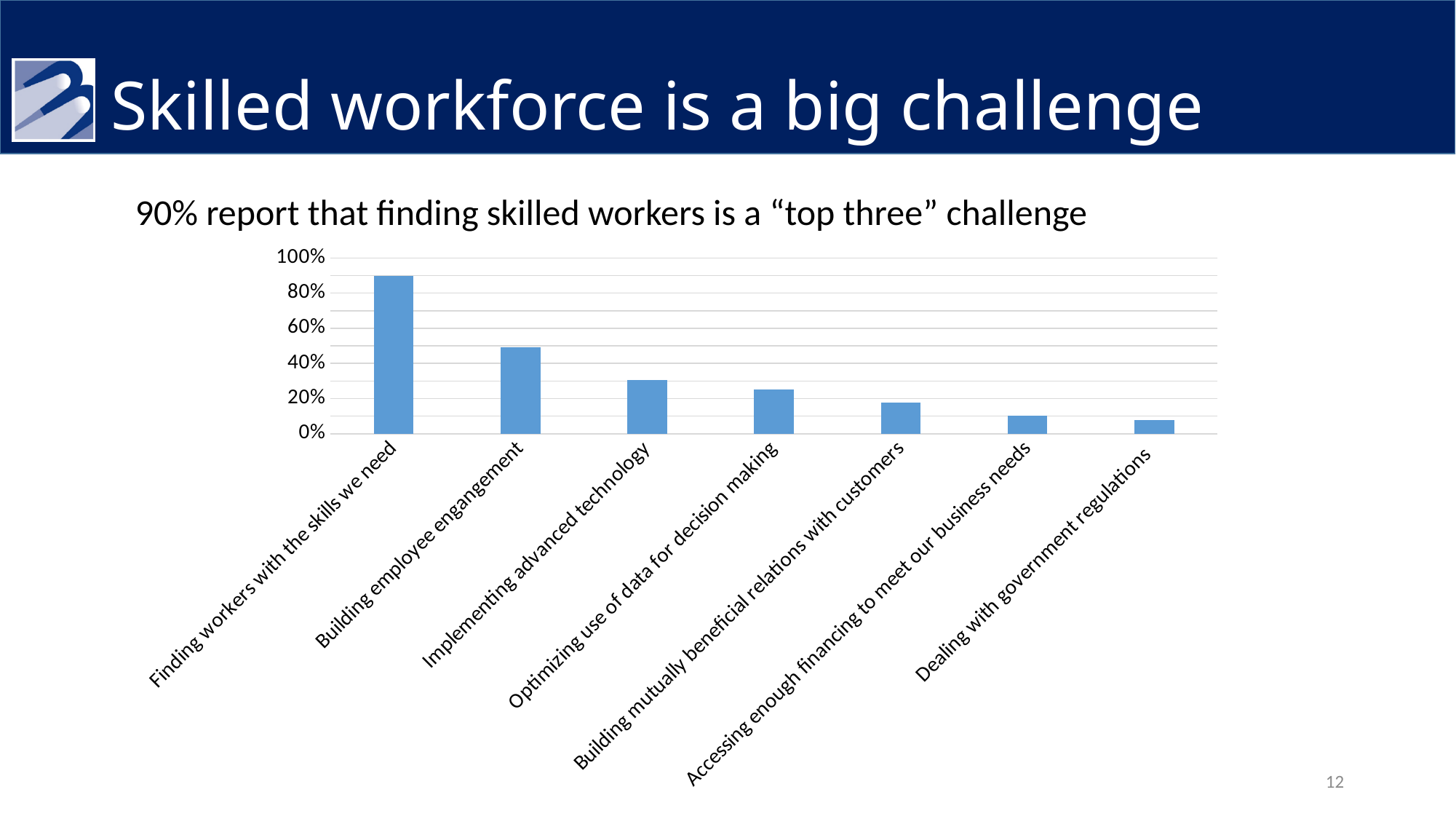
Is the value for Implementing advanced technology greater or less than 40%? less Do the bar values rise or fall from left to right along the x axis? fall Which category has the lowest value in the chart? Dealing with government regulations Which category has the highest value in the chart? Finding workers with the skills we need What kind of chart is shown on the slide? bar chart Is the value for Optimizing use of data for decision making greater or less than 20%? greater How many categories are shown on the x axis of the chart? 7 According to the slide, what percentage report that finding skilled workers is a "top three" challenge? 90% Which is larger: the value for Building employee engangement or the value for Implementing advanced technology? Building employee engangement What is the title of the slide? Skilled workforce is a big challenge Is the value for Building employee engangement greater or less than 40%? greater